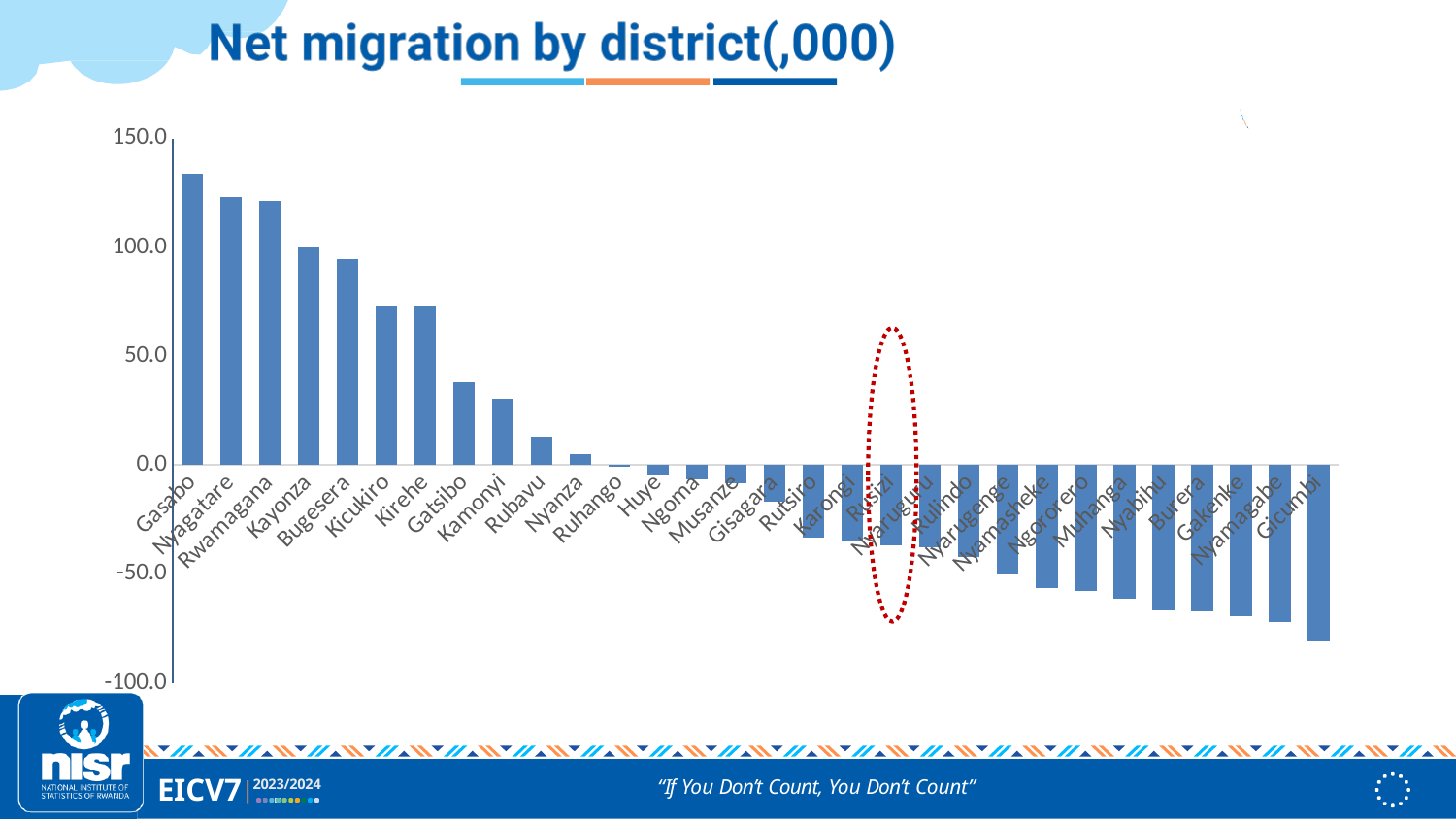
Is the value for Gicumbi greater or less than -50.0? less How many districts are plotted in the chart? 30 Which has the larger net migration, Gasabo or Nyagatare? Gasabo Which district has the highest net migration? Gasabo What is the title of the chart? Net migration by district(,000) Is the value for Kicukiro greater or less than 50.0? greater Is the value for Gatsibo greater or less than 50.0? less What kind of chart is shown on the slide? bar chart Do the values rise or fall moving from left to right along the x axis? fall Which district has the lowest net migration? Gicumbi Which district's bar is highlighted with a red dotted circle? Rusizi